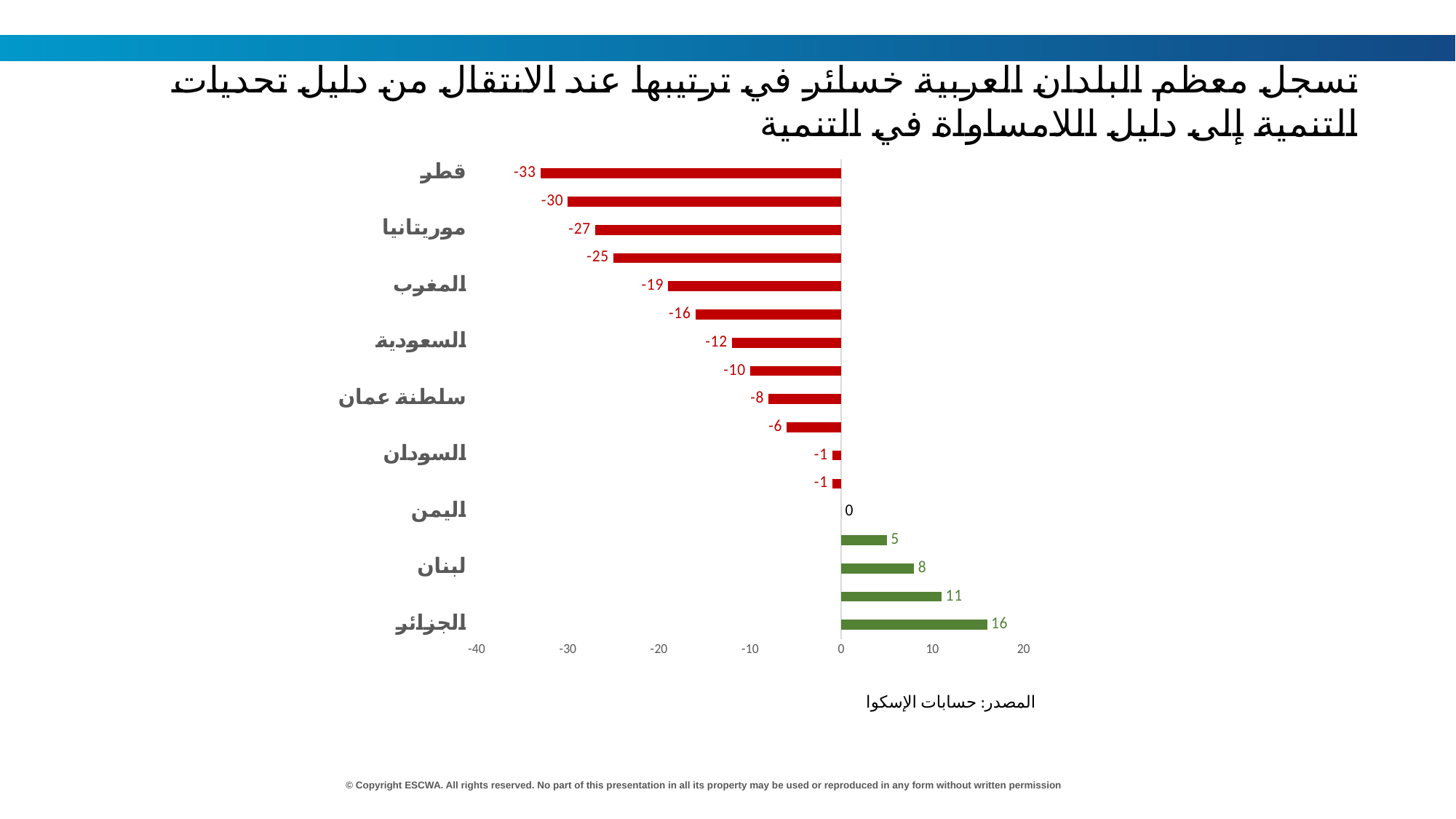
What colour are the bars with positive values? Green What is the difference between the values for الجزائر and لبنان? 8 What is the value shown for اليمن? 0 Which has a larger value, السعودية or سلطنة عمان? سلطنة عمان What is the value shown for المغرب? -19 Which labelled country has the highest value? الجزائر Which labelled country has the lowest value? قطر What is the value shown for لبنان? 8 How many bars are plotted in the chart? 17 What is the value shown for الجزائر? 16 What type of chart is shown on the slide? Bar chart What is the value shown for قطر? -33